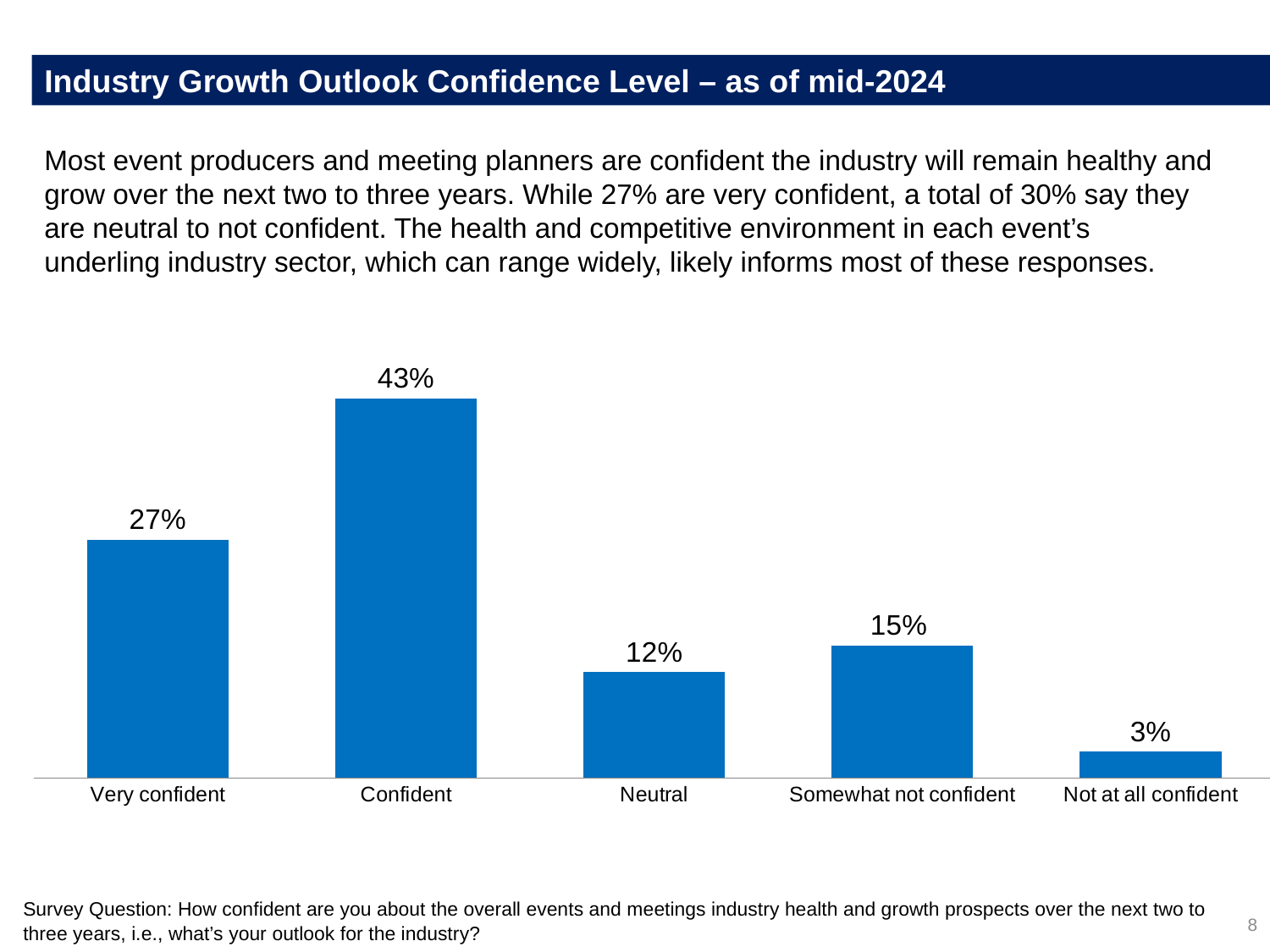
What percentage of respondents are Somewhat not confident? 15% What percentage of respondents are Not at all confident? 3% Which confidence level has the highest percentage of respondents? Confident What percentage of respondents are Neutral? 12% What percentage of respondents are Confident? 43% How many confidence level categories are shown in the chart? 5 Which is larger, the percentage for Neutral or for Somewhat not confident? Somewhat not confident What type of chart is shown on the slide? Bar chart What is the difference in percentage points between Somewhat not confident and Neutral? 3 What percentage of respondents are Very confident? 27% Which confidence level has the lowest percentage of respondents? Not at all confident What is the difference in percentage points between Confident and Very confident? 16